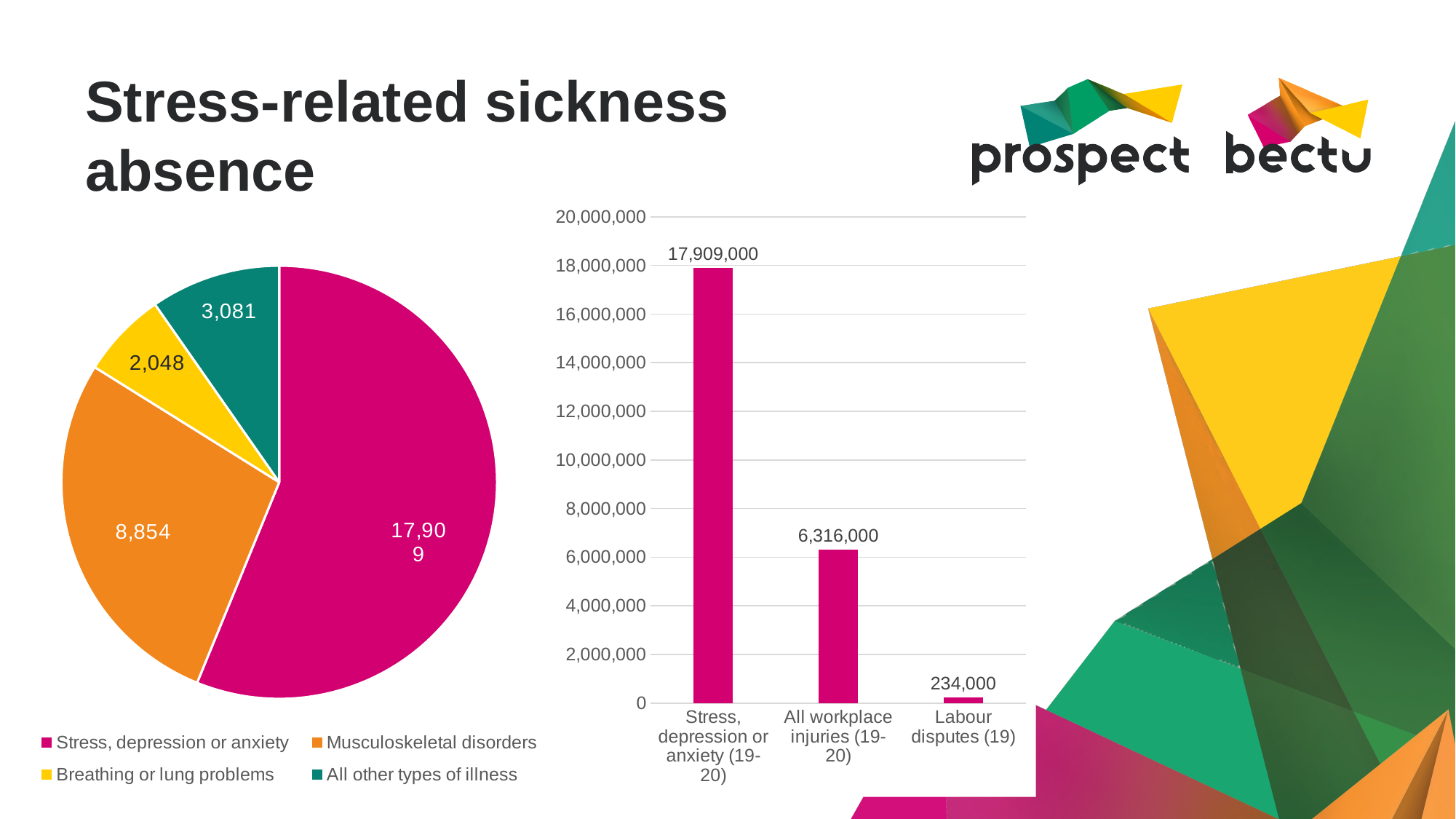
In the bar chart on the right, which category has the lowest value? Labour disputes (19) In the pie chart on the left, which category has the smallest slice? Breathing or lung problems In the pie chart on the left, what is the value for All other types of illness? 3,081 In the pie chart on the left, what is the difference between Musculoskeletal disorders and All other types of illness? 5,773 In the pie chart on the left, what is the value for Musculoskeletal disorders? 8,854 In the pie chart on the left, what is the value for Breathing or lung problems? 2,048 What kind of chart is shown on the right of the slide? Bar chart In the pie chart on the left, how many categories does the legend list? 4 In the bar chart on the right, what is the value for Labour disputes (19)? 234,000 In the pie chart on the left, which category has the largest slice? Stress, depression or anxiety In the bar chart on the right, what is the difference between Stress, depression or anxiety (19-20) and All workplace injuries (19-20)? 11,593,000 In the bar chart on the right, what is the value for All workplace injuries (19-20)? 6,316,000